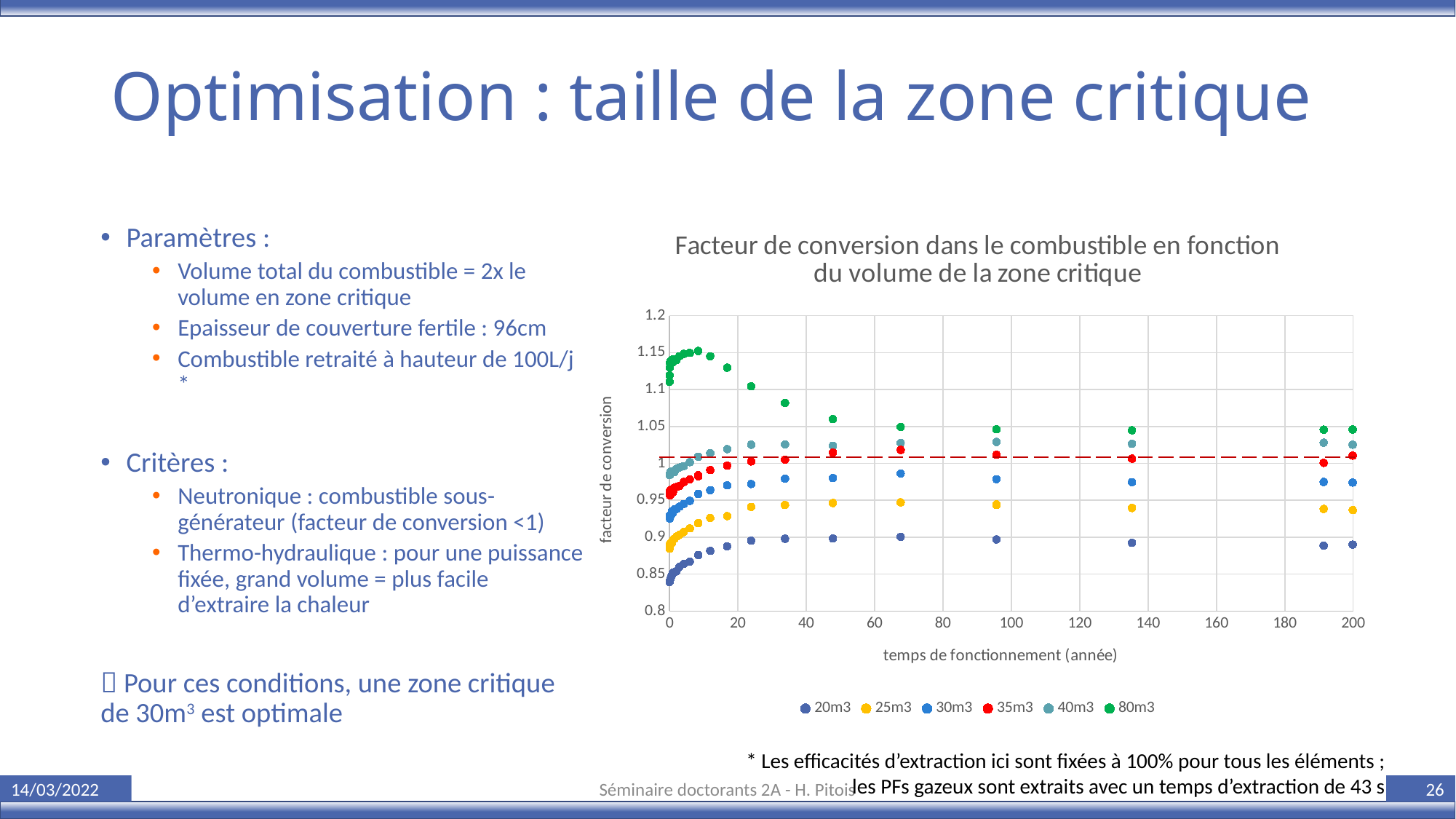
What is the label of the x axis of the chart? temps de fonctionnement (année) What kind of chart is shown on the slide? scatter chart How many series does the legend of the chart list? 6 Is the value for the 80m3 series at 200 years greater or less than 1? greater Is the value for the 30m3 series at 200 years greater or less than 0.95? greater At 200 years, which series has the larger value: 40m3 or 25m3? 40m3 Is the value for the 20m3 series at 200 years greater or less than 0.9? less What is the title of the chart? Facteur de conversion dans le combustible en fonction du volume de la zone critique Between 20 and 100 years of operation, does the 80m3 series rise or fall? fall Which series has the lowest conversion factor values across the chart? 20m3 Which series has the highest conversion factor values across the chart? 80m3